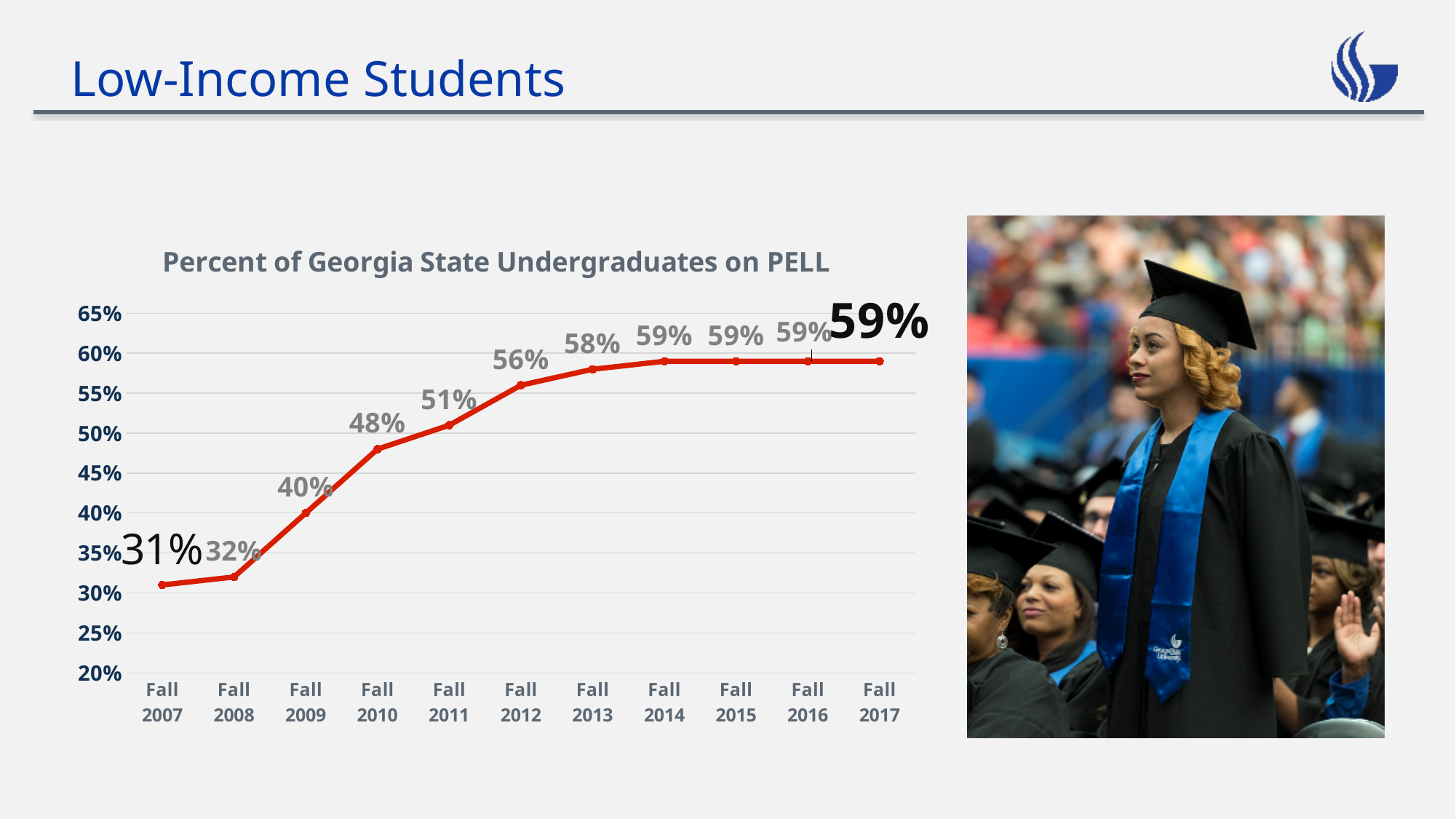
What is the title of the chart? Percent of Georgia State Undergraduates on PELL What is the percent of Georgia State undergraduates on PELL in Fall 2017? 59% What kind of chart is shown on the slide? Line chart Which year has the lowest percent of undergraduates on PELL? Fall 2007 What is the difference between the Fall 2009 and Fall 2008 values? 8 percentage points What is the percent of Georgia State undergraduates on PELL in Fall 2012? 56% What is the difference between the Fall 2017 value and the Fall 2007 value? 28 percentage points How many data points are plotted on the chart? 11 Which is larger, the value for Fall 2011 or the value for Fall 2013? Fall 2013 What is the percent of Georgia State undergraduates on PELL in Fall 2007? 31% Do the values generally rise or fall from Fall 2007 to Fall 2017? Rise What is the value shown for Fall 2010? 48%